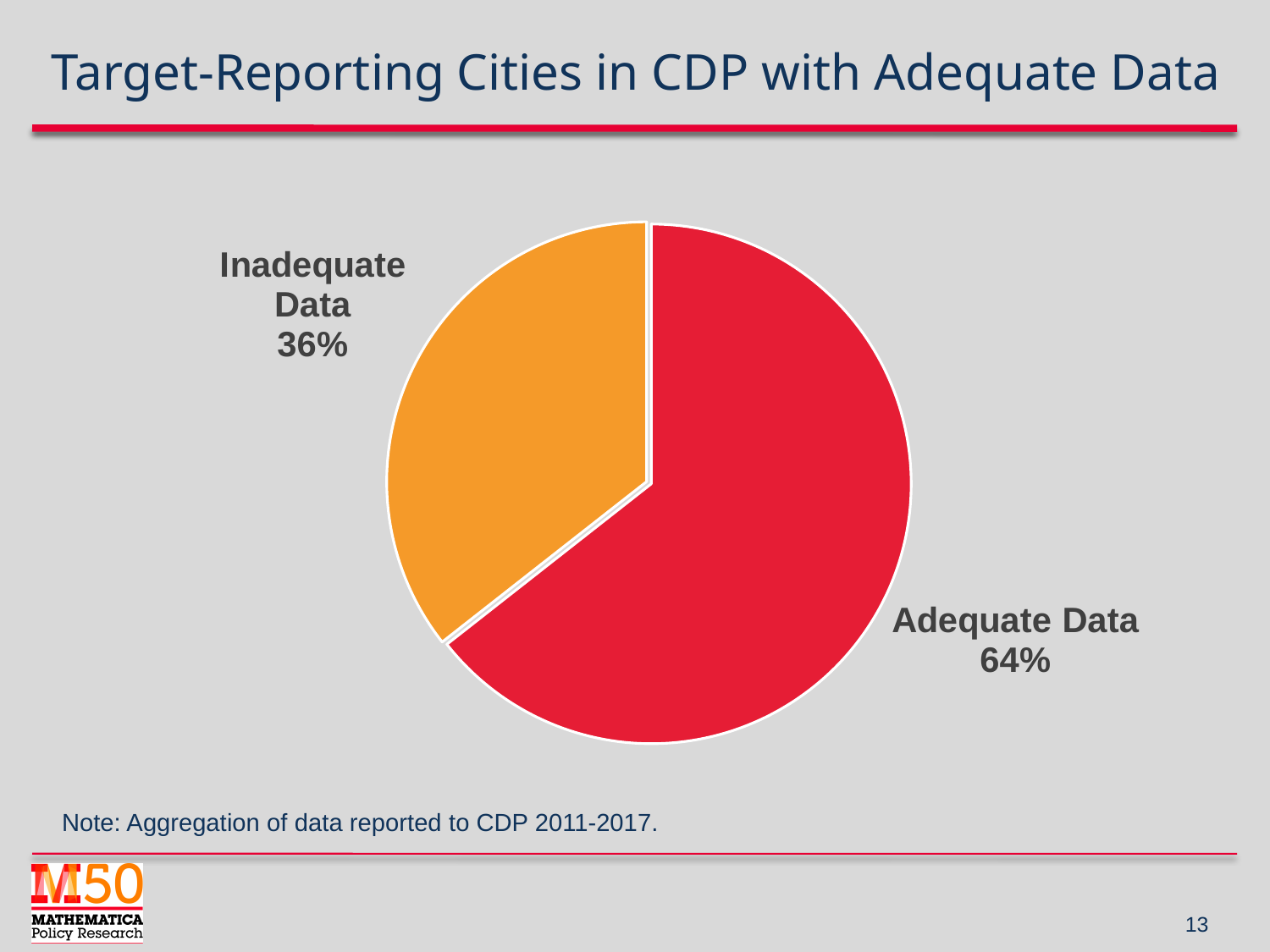
Which slice of the pie is the largest? Adequate Data What is the title of the slide containing the pie chart? Target-Reporting Cities in CDP with Adequate Data Which is larger, the Adequate Data slice or the Inadequate Data slice? Adequate Data What share of target-reporting cities have Adequate Data? 64% How many slices does the pie chart have? 2 Which slice of the pie is the smallest? Inadequate Data What kind of chart is shown on the slide? pie chart What colour is the Inadequate Data slice? orange What share of target-reporting cities have Inadequate Data? 36% What is the difference in percentage points between the Adequate Data and Inadequate Data slices? 28